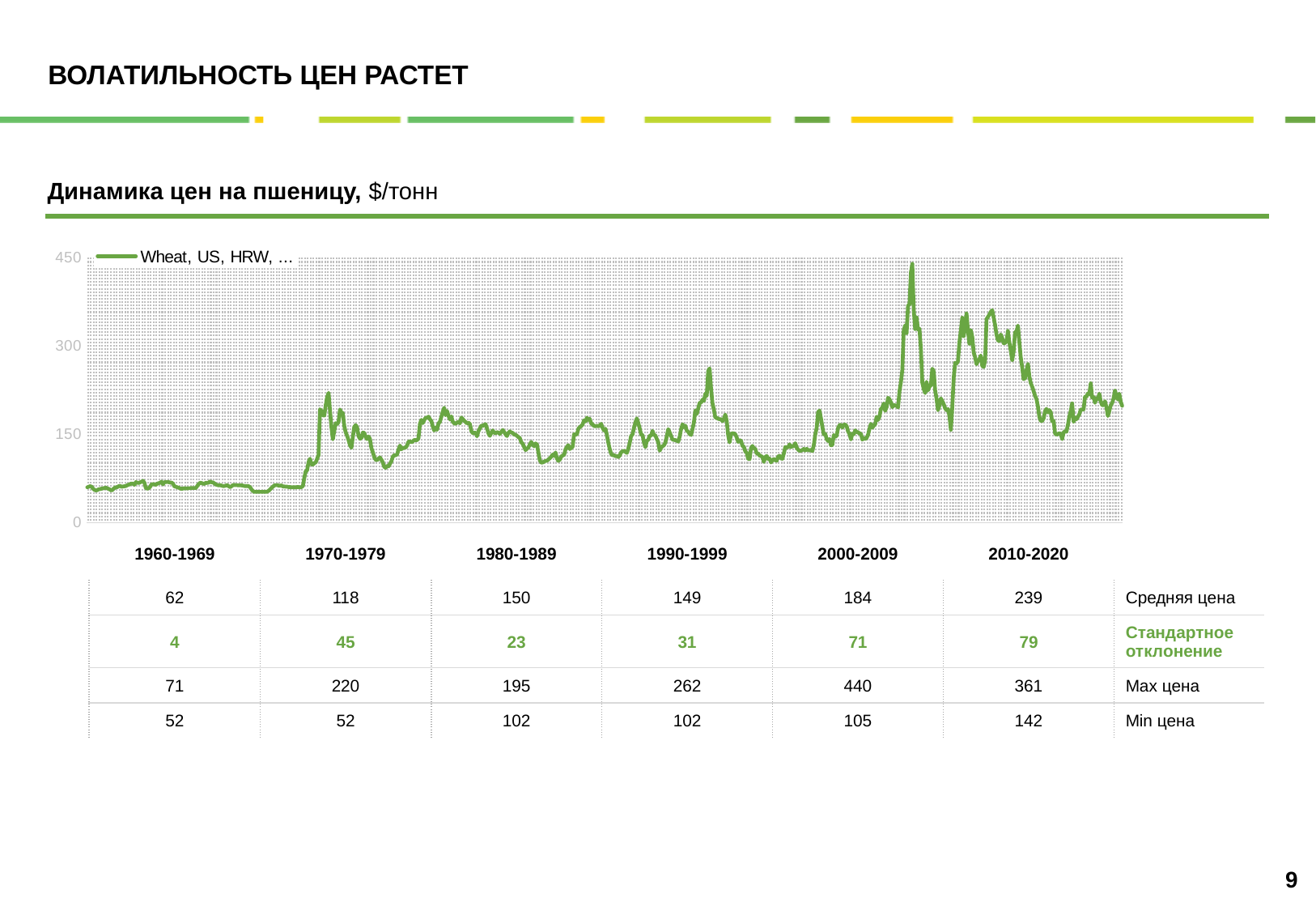
Which decade in the table has the highest standard deviation (Стандартное отклонение)? 2010-2020 Which decade in the table has the lowest average price (Средняя цена)? 1960-1969 According to the table below the chart, what is the average price (Средняя цена) for 2010-2020? 239 Is the wheat price at the start of the 1960s greater or less than 150 $/тонн? less How many series does the chart legend list? 1 Is the max price (Max цена) for 1990-1999 larger than the max price for 1980-1989? Yes According to the table below the chart, what is the max price (Max цена) for 2000-2009? 440 What is the name of the series shown in the chart legend? Wheat, US, HRW, ... What kind of chart is shown on the slide? line chart Does the wheat price generally rise or fall from the 1960s to the 2010s? rise What is the highest value shown on the chart's vertical axis? 450 What is the difference between the average price for 2010-2020 and the average price for 1960-1969? 177